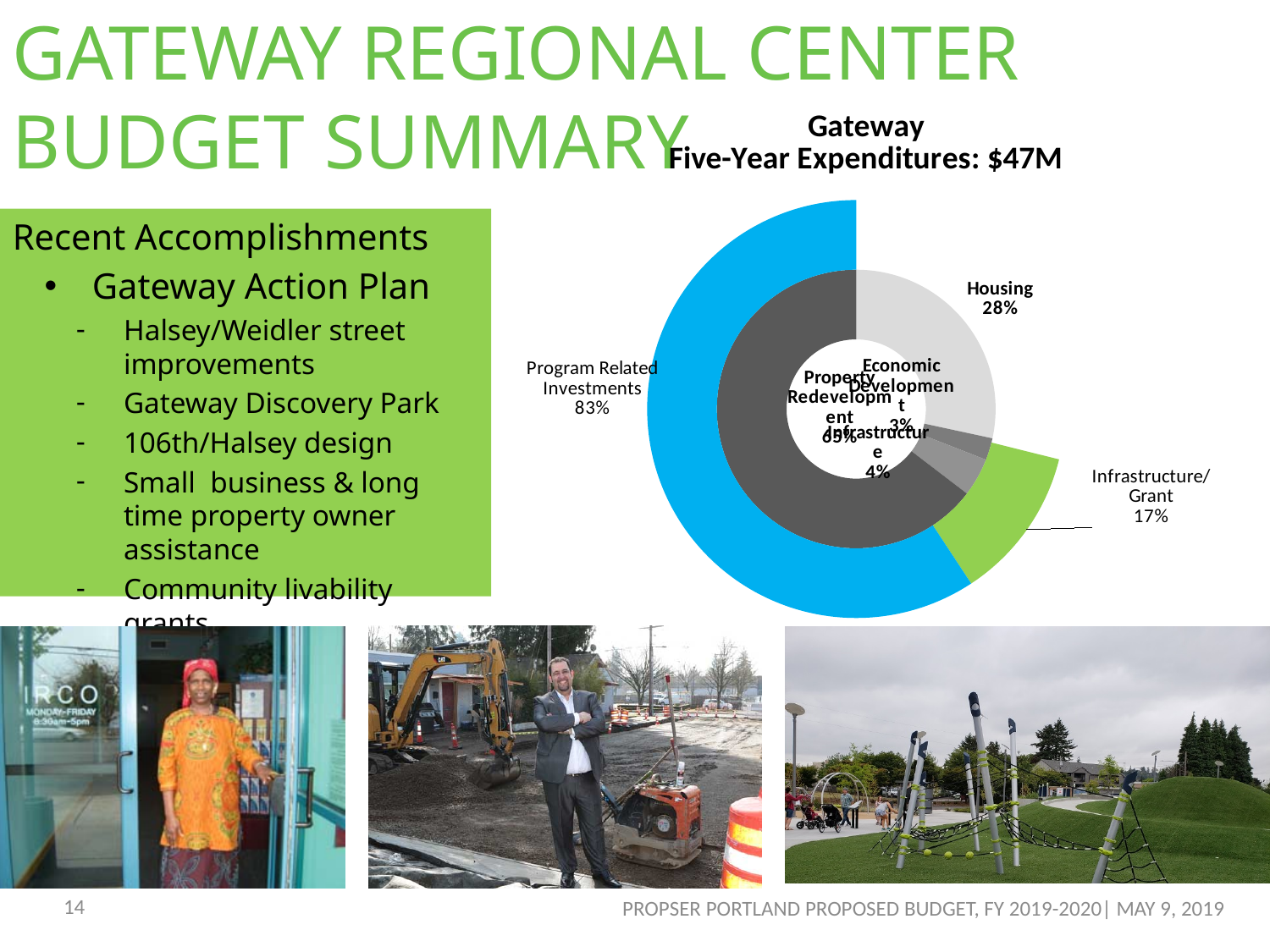
Which category has the largest share in the outer ring? Program Related Investments What percentage of the outer ring is Infrastructure/Grant? 17% What is the title of the doughnut chart on the slide? Gateway Five-Year Expenditures: $47M What kind of chart is shown on the slide? doughnut chart What is the difference in percentage points between Program Related Investments and Infrastructure/Grant? 66 What percentage of the outer ring is Program Related Investments? 83% What percentage is shown for Housing in the inner ring? 28% How many categories are labelled in the outer ring of the chart? 2 What is the total five-year expenditure amount stated in the chart title? $47M Is the share for Housing greater or less than the share for Infrastructure/Grant? greater Which category has the smallest share in the outer ring? Infrastructure/Grant Which of the two outer-ring categories, Program Related Investments or Infrastructure/Grant, has the larger share? Program Related Investments